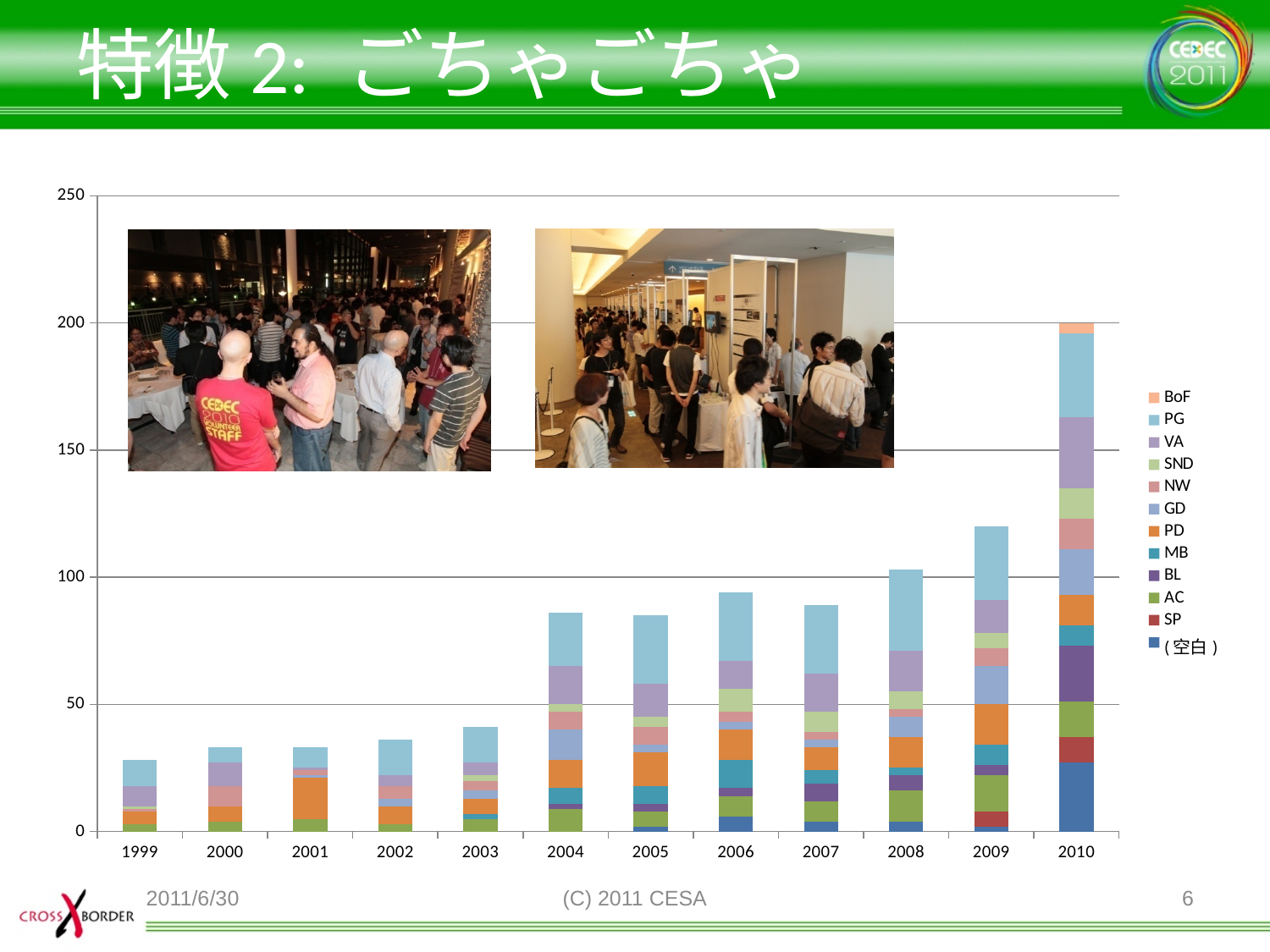
Which year has the shortest stacked bar? 1999 Is the total for 2003 greater or less than 50? less How many years are shown along the x axis of the chart? 12 Which year has the tallest stacked bar? 2010 What kind of chart is shown on the slide? stacked bar chart Is the total for 2009 greater or less than 100? greater Is the total for 2010 greater or less than 150? greater Do the bar totals generally rise or fall from 1999 to 2010? rise Which series is listed first (at the top) in the chart's legend? BoF How many series does the chart's legend list? 12 Which year has the larger total, 2008 or 2005? 2008